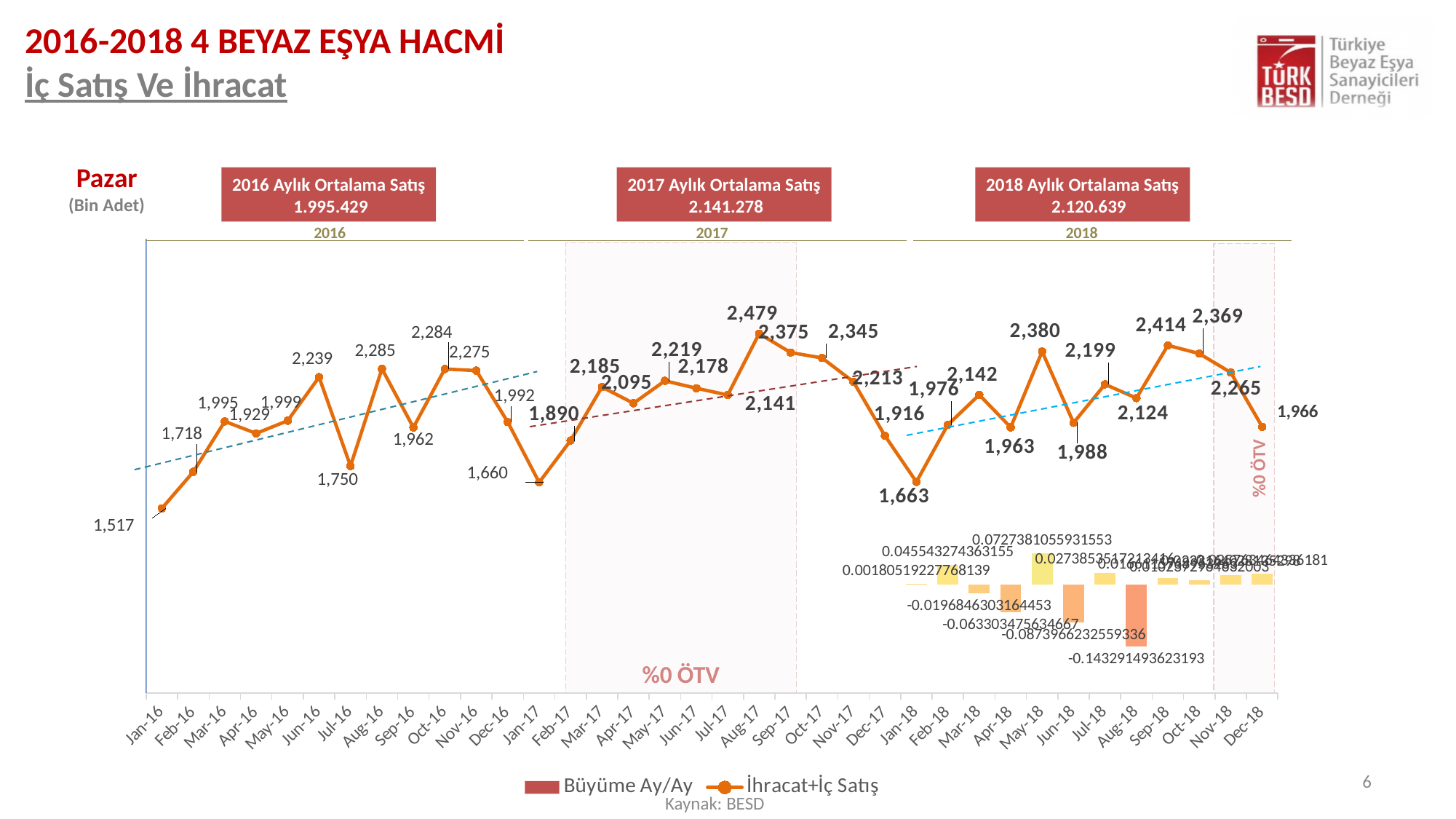
What is the İhracat+İç Satış value for Jan-16? 1,517 What kind of chart is used to plot the İhracat+İç Satış series? line chart What is the 2017 monthly average sales (2017 Aylık Ortalama Satış) shown above the chart? 2.141.278 Which month has the lowest İhracat+İç Satış value? Jan-16 Which month has the highest İhracat+İç Satış value? Aug-17 Which is larger, the İhracat+İç Satış value for Jun-16 or for Jun-17? Jun-16 What is the difference between the İhracat+İç Satış values for Aug-17 and Jan-16? 962 What is the difference between the İhracat+İç Satış values for Sep-18 and Oct-18? 45 What is the İhracat+İç Satış value for Aug-17? 2,479 How many monthly data points does the İhracat+İç Satış series have? 36 How many series does the legend list? 2 What is the İhracat+İç Satış value for Dec-18? 1,966